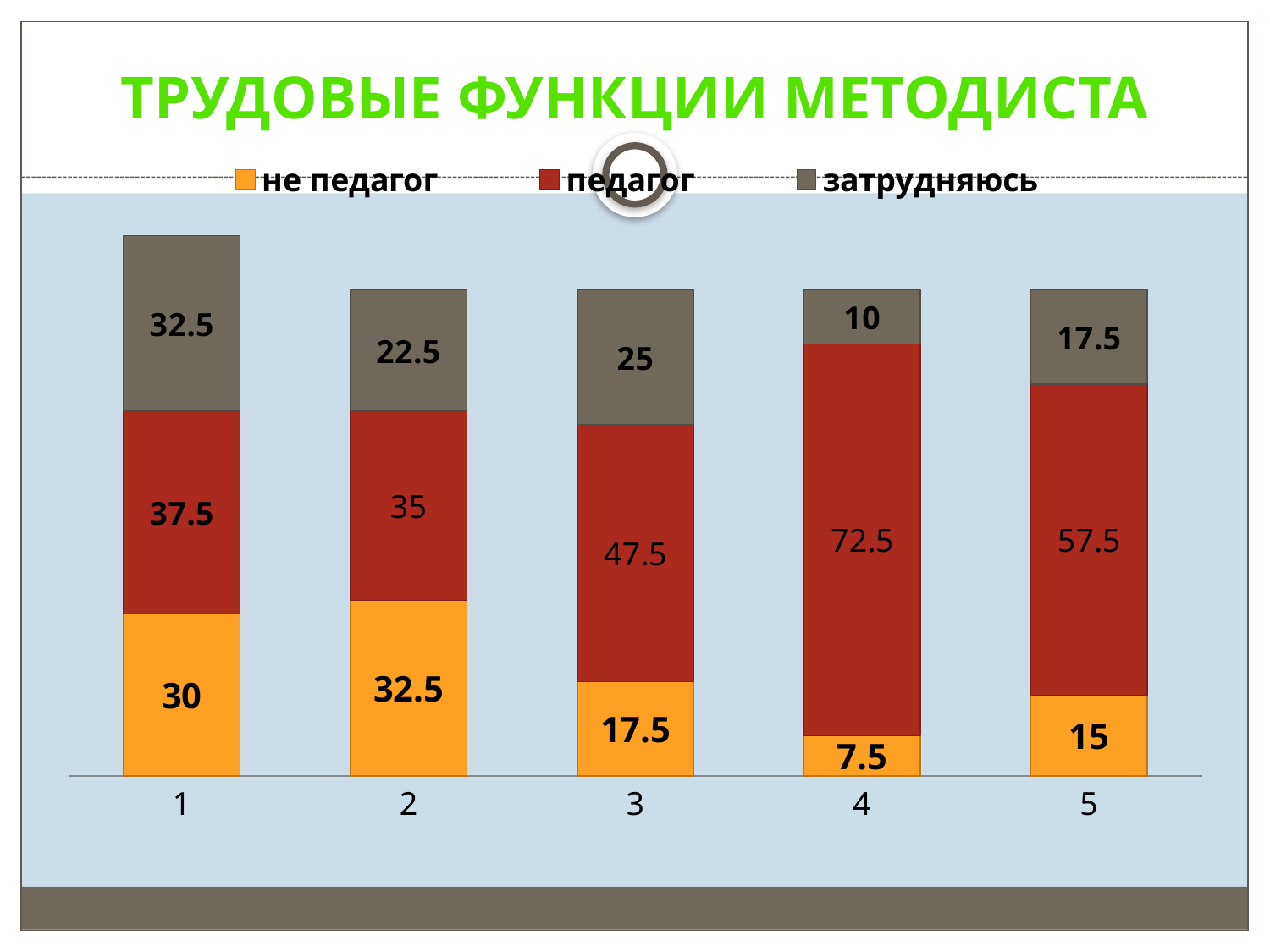
How many series does the legend list? 3 What is the difference between the "педагог" values for categories 4 and 1? 35 Which category has the highest value for "педагог"? 4 How many categories are shown on the x axis? 5 What is the value for "педагог" in category 4? 72.5 What is the total of the stacked bar for category 4? 90 What is the value for "затрудняюсь" in category 1? 32.5 What is the value for "не педагог" in category 2? 32.5 Which category has the lowest value for "не педагог"? 4 Which is larger: the "затрудняюсь" value for category 3 or for category 5? category 3 What is the total of the stacked bar for category 1? 100 What kind of chart is shown on the slide? stacked bar chart